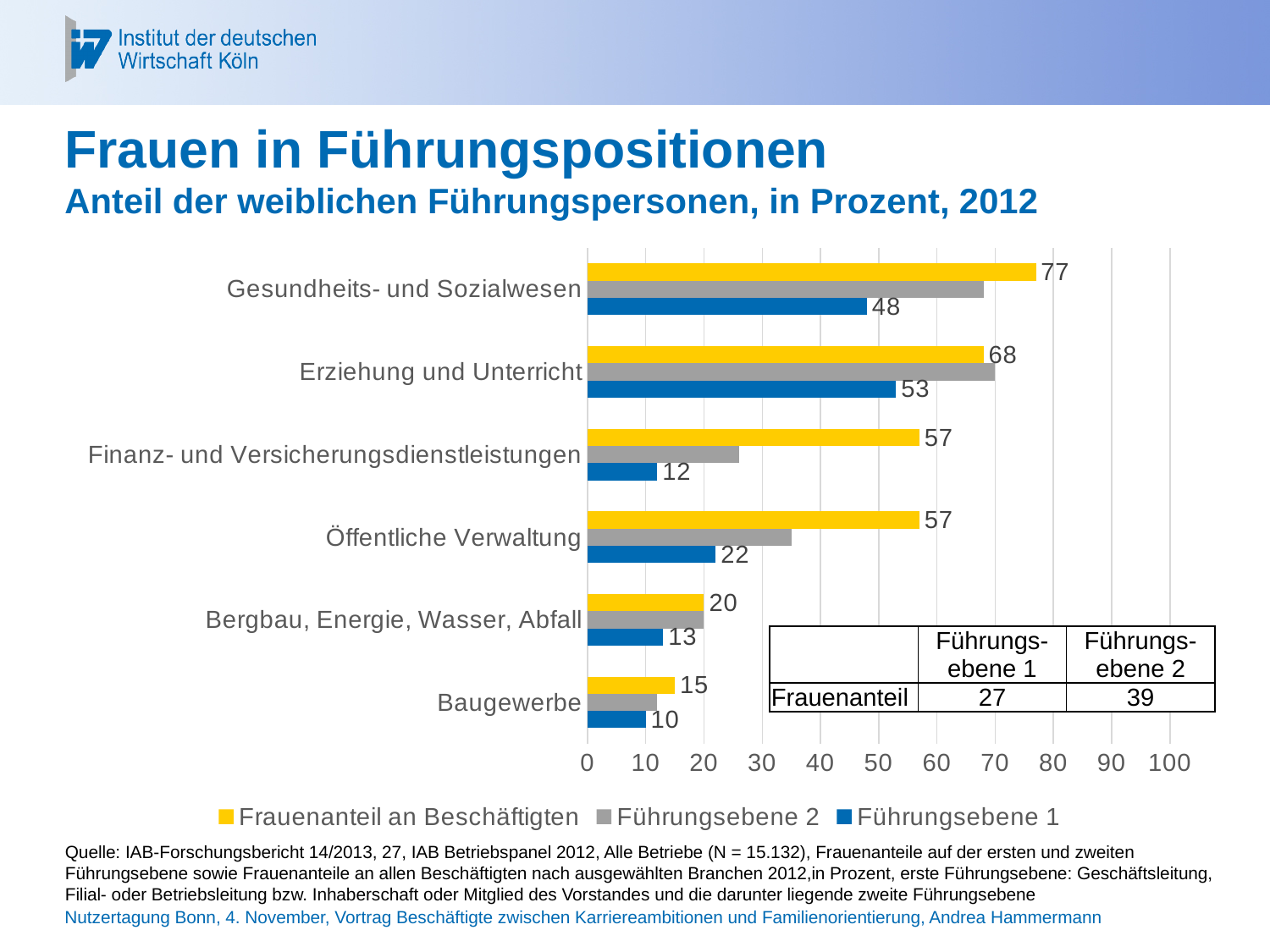
Which category has the highest value for Führungsebene 1? Erziehung und Unterricht How many series does the legend list? 3 What is the value of Frauenanteil an Beschäftigten for Gesundheits- und Sozialwesen? 77 What is the difference between Frauenanteil an Beschäftigten and Führungsebene 1 for Gesundheits- und Sozialwesen? 29 Which category has the lowest value for Frauenanteil an Beschäftigten? Baugewerbe How many categories (branches) are shown in the chart? 6 Is the Führungsebene 2 value for Finanz- und Versicherungsdienstleistungen greater or less than 30? less What is the value of Führungsebene 1 for Baugewerbe? 10 Which is larger for Öffentliche Verwaltung: Frauenanteil an Beschäftigten or Führungsebene 1? Frauenanteil an Beschäftigten Is the Führungsebene 2 value for Erziehung und Unterricht greater or less than 60? greater What type of chart is shown on the slide? Bar chart What is the value of Führungsebene 1 for Finanz- und Versicherungsdienstleistungen? 12